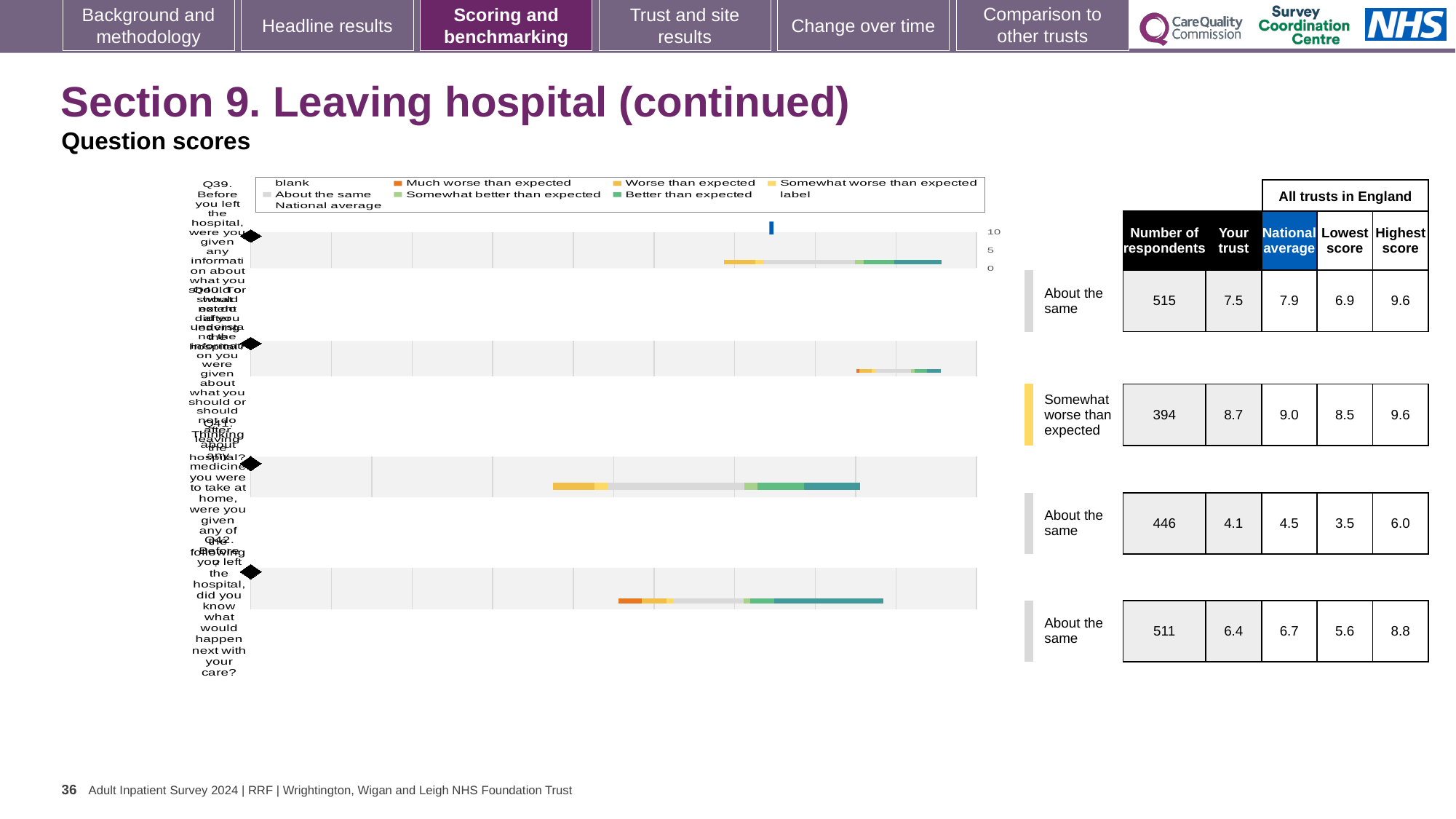
In the table beside the chart, what is the 'Your trust' score for the third row (Q41)? 4.1 In the table beside the chart, what is the 'Your trust' score for the first row (Q39)? 7.5 In the table beside the chart, is the 'Your trust' score for the second row (Q40) higher or lower than the national average? lower In the table beside the chart, what is the highest score for the fourth row (Q42)? 8.8 What kind of chart is used to show the question scores on this slide? bar chart In the chart legend, what colour represents 'Much worse than expected'? orange In the table beside the chart, what is the difference between the national average and 'Your trust' score for the fourth row (Q42)? 0.3 In the table beside the chart, which row has the highest 'Your trust' score? Q40 (second row), 8.7 In the table beside the chart, what is the national average for the first row (Q39)? 7.9 How many question bars (rows) are plotted in the chart? 4 In the table beside the chart, how many respondents are listed for the second row (Q40)? 394 In the chart legend, what colour represents 'Better than expected'? teal